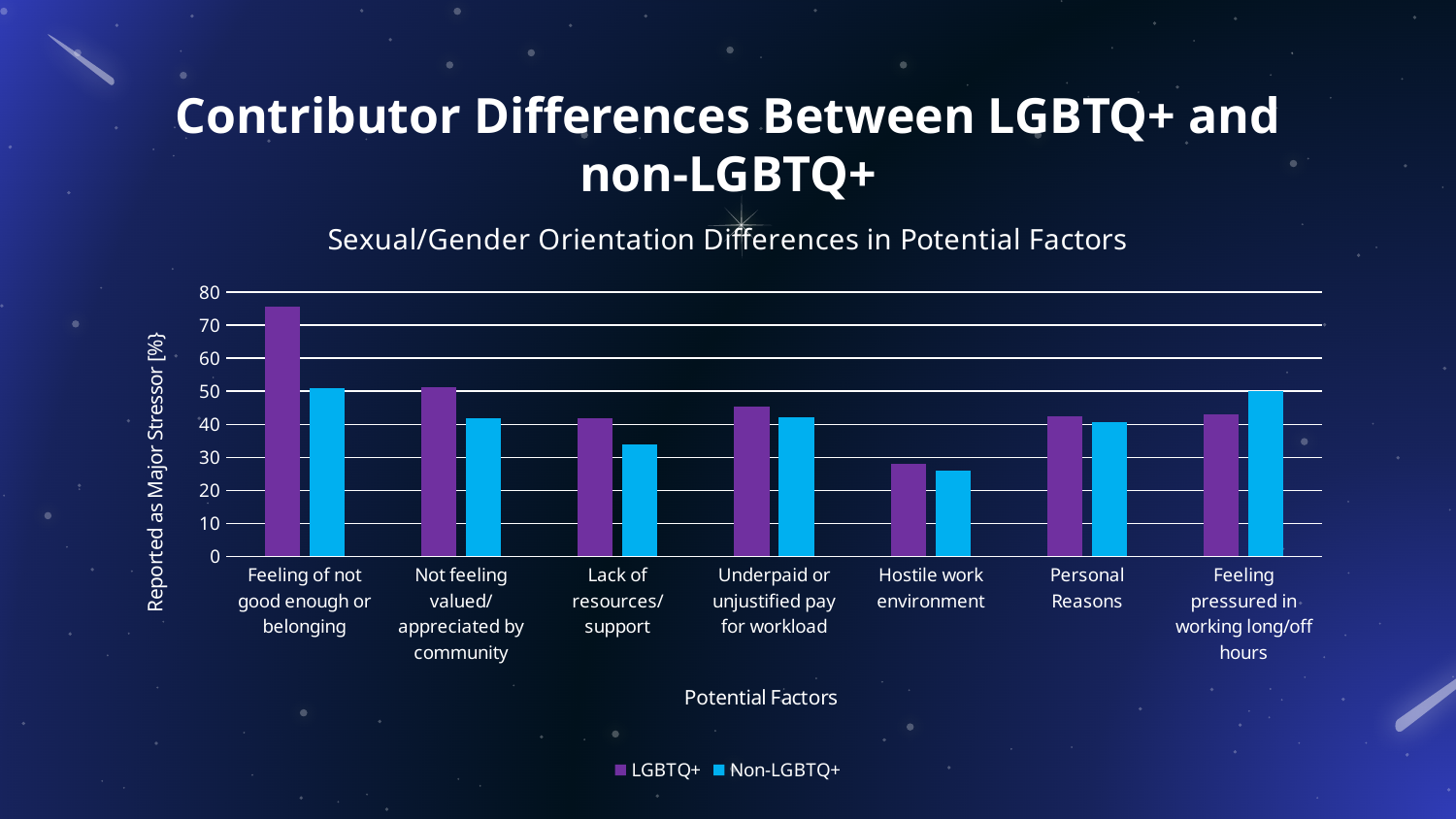
Which potential factor has the lowest value for the LGBTQ+ series? Hostile work environment What kind of chart is shown on the slide? Bar chart Is the LGBTQ+ value for 'Hostile work environment' greater or less than 30? less How many potential factors (categories) are shown on the x axis? 7 How many series does the legend list? 2 For 'Feeling pressured in working long/off hours', which series has the larger value, LGBTQ+ or Non-LGBTQ+? Non-LGBTQ+ Which potential factor has the highest value for the LGBTQ+ series? Feeling of not good enough or belonging What is the label of the y axis of the chart? Reported as Major Stressor [%] For 'Not feeling valued/appreciated by community', which series has the larger value, LGBTQ+ or Non-LGBTQ+? LGBTQ+ Is the Non-LGBTQ+ value for 'Lack of resources/support' greater or less than 40? less Which potential factor has the lowest value for the Non-LGBTQ+ series? Hostile work environment Is the LGBTQ+ value for 'Feeling of not good enough or belonging' greater or less than 70? greater